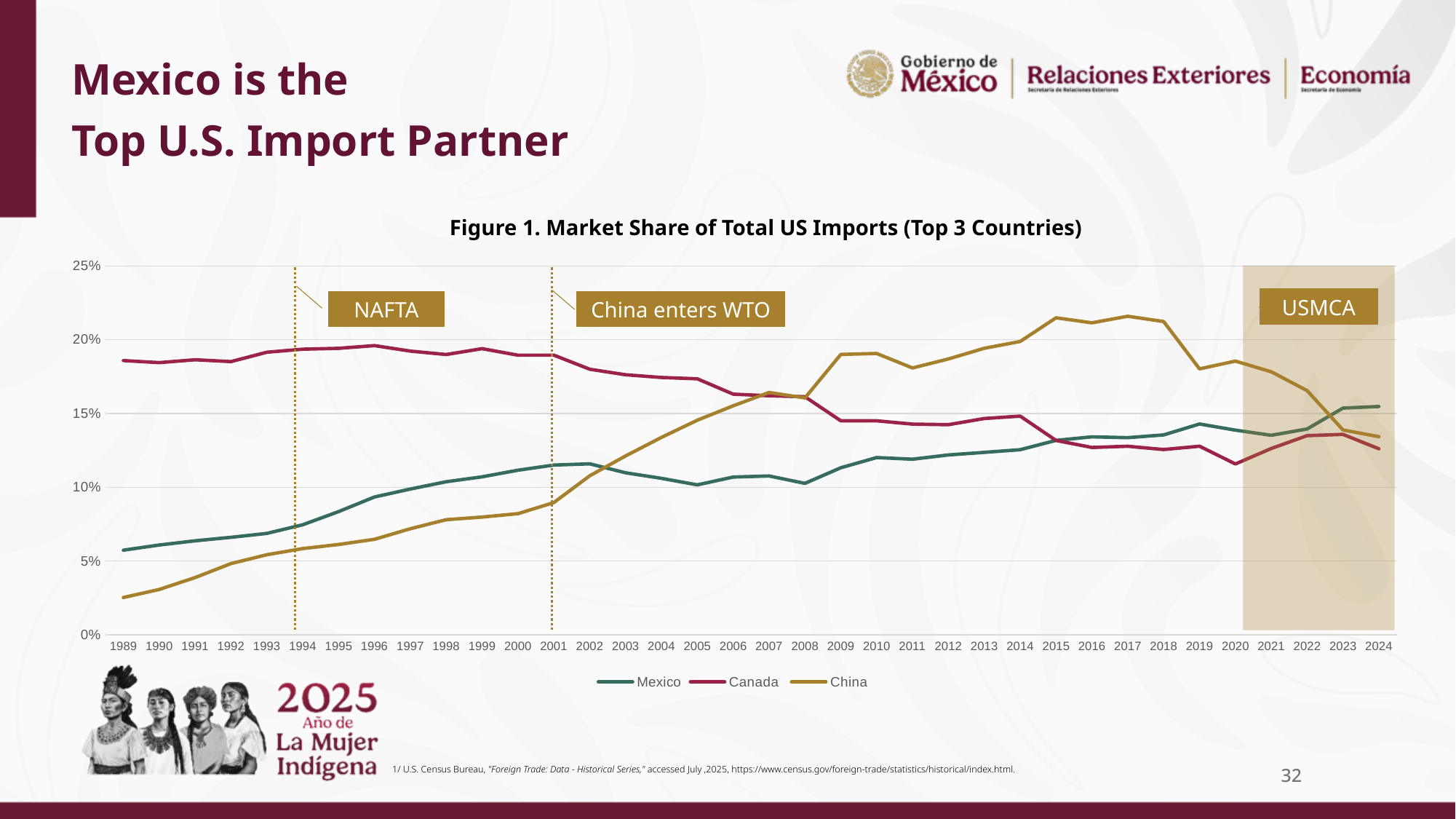
What is the title of the chart? Figure 1. Market Share of Total US Imports (Top 3 Countries) Does the Mexico series generally rise or fall from 1989 to 2024? rise Which series has the lowest value in 1995? China How many years are shown on the x axis of the chart? 36 In 1989, which series has the larger value, Canada or Mexico? Canada Is the value for China in 1989 greater or less than 5%? less What kind of chart is shown on the slide? line chart How many series does the legend list? 3 Is the value for Mexico in 1989 greater or less than 10%? less Is the value for China in 2015 greater or less than 20%? greater In 2024, which series has the larger value, Mexico or China? Mexico Which event is marked by the shaded region at the right end of the chart? USMCA